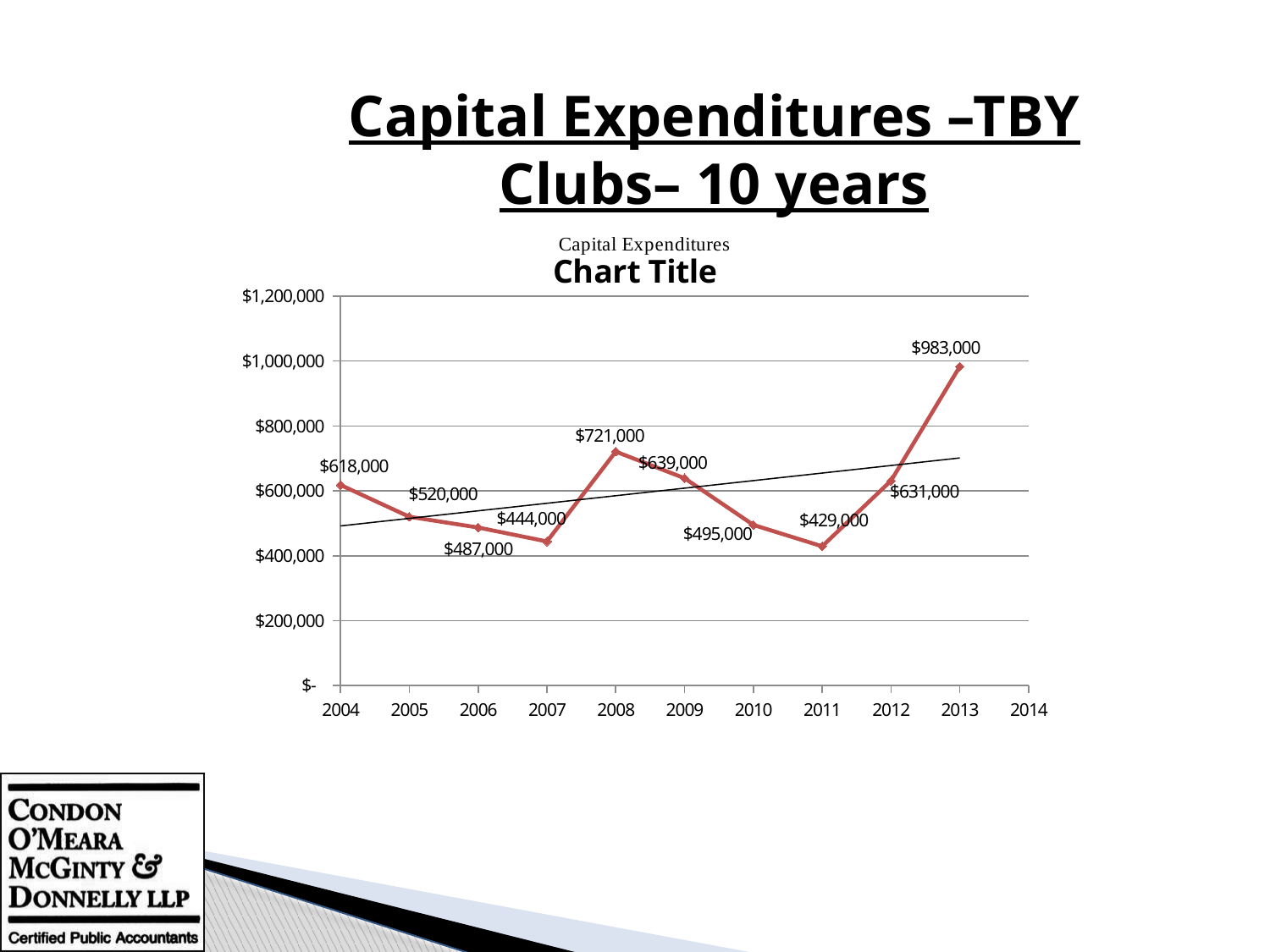
Which year has the lowest capital expenditure? 2011 What kind of chart is shown on the slide? line chart Which year has the highest capital expenditure? 2013 How many years have data points plotted on the chart? 10 What is the capital expenditure value for 2013? $983,000 What is the capital expenditure value for 2004? $618,000 What is the difference between the capital expenditure in 2013 and in 2012? $352,000 What is the capital expenditure value for 2011? $429,000 Is the capital expenditure for 2013 greater or less than $800,000? greater What is the capital expenditure value for 2008? $721,000 Which year has the larger capital expenditure, 2009 or 2010? 2009 What is the difference between the capital expenditure in 2008 and in 2007? $277,000